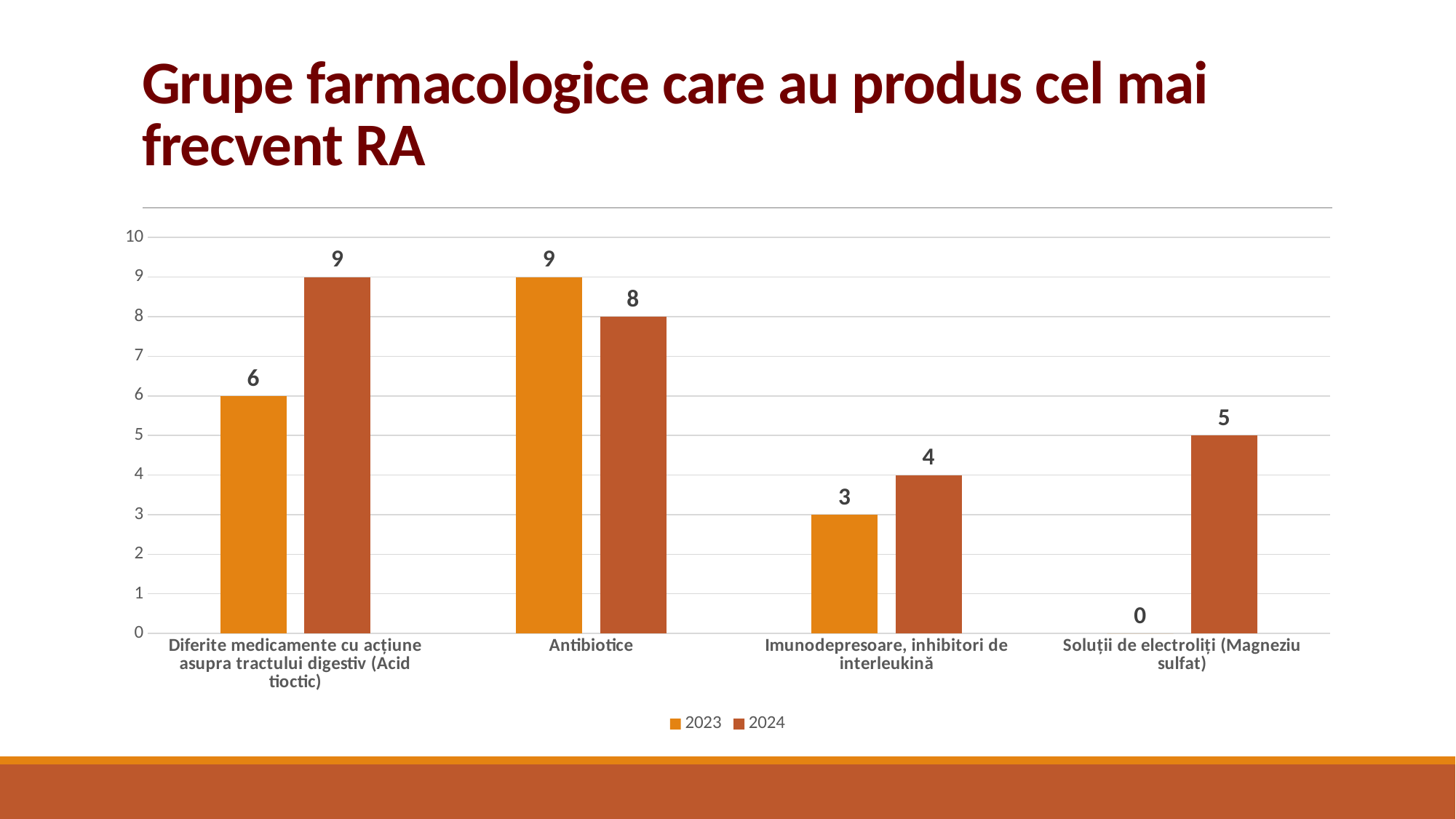
What is the title of the slide? Grupe farmacologice care au produs cel mai frecvent RA What is the 2023 value for Imunodepresoare, inhibitori de interleukină? 3 Which is larger for Antibiotice, the 2023 value or the 2024 value? 2023 Which category has the highest 2023 value? Antibiotice Which category has the lowest 2024 value? Imunodepresoare, inhibitori de interleukină What is the 2023 value for Soluții de electroliți (Magneziu sulfat)? 0 How many series does the legend list? 2 What is the 2024 value for Antibiotice? 8 What is the difference between the 2024 and 2023 values for Diferite medicamente cu acțiune asupra tractului digestiv (Acid tioctic)? 3 What is the total of the 2024 values across all four categories? 26 What kind of chart is shown on the slide? Bar chart How many categories are shown on the x axis? 4